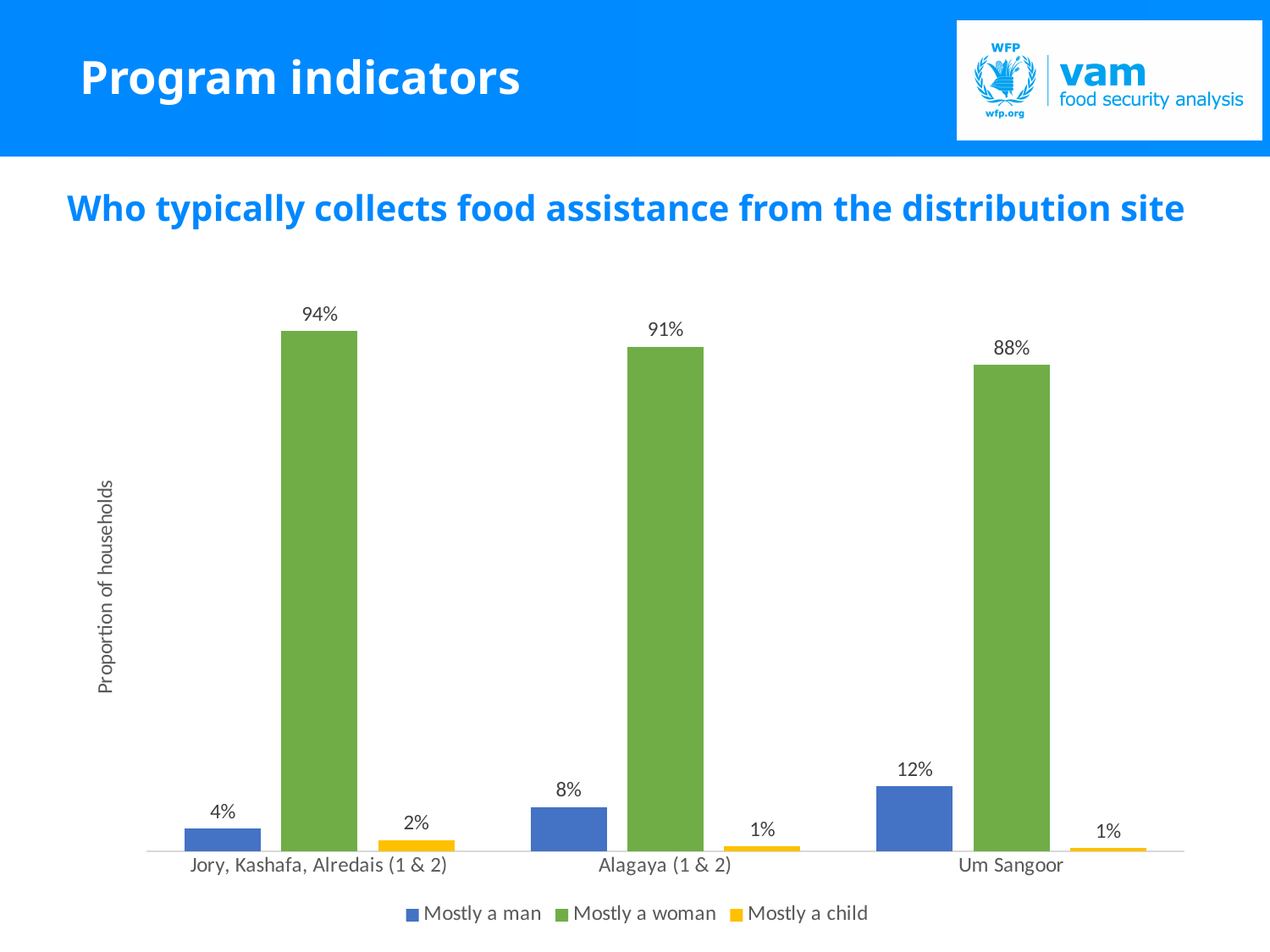
What is the value for 'Mostly a man' in Um Sangoor? 12% Do the 'Mostly a woman' values rise or fall from left to right across the locations? Fall Which location has the lowest value for 'Mostly a man'? Jory, Kashafa, Alredais (1 & 2) Which location has the highest value for 'Mostly a woman'? Jory, Kashafa, Alredais (1 & 2) How many locations are shown on the x axis? 3 Which is larger: the 'Mostly a man' value for Alagaya (1 & 2) or for Um Sangoor? Um Sangoor What is the difference between the 'Mostly a woman' values for Jory, Kashafa, Alredais (1 & 2) and Um Sangoor? 6% What percentage of households in Alagaya (1 & 2) report that mostly a woman collects food assistance? 91% What is the value for 'Mostly a child' in Jory, Kashafa, Alredais (1 & 2)? 2% What is the label on the vertical axis of the chart? Proportion of households How many series does the legend list? 3 What kind of chart is shown on the slide? Bar chart